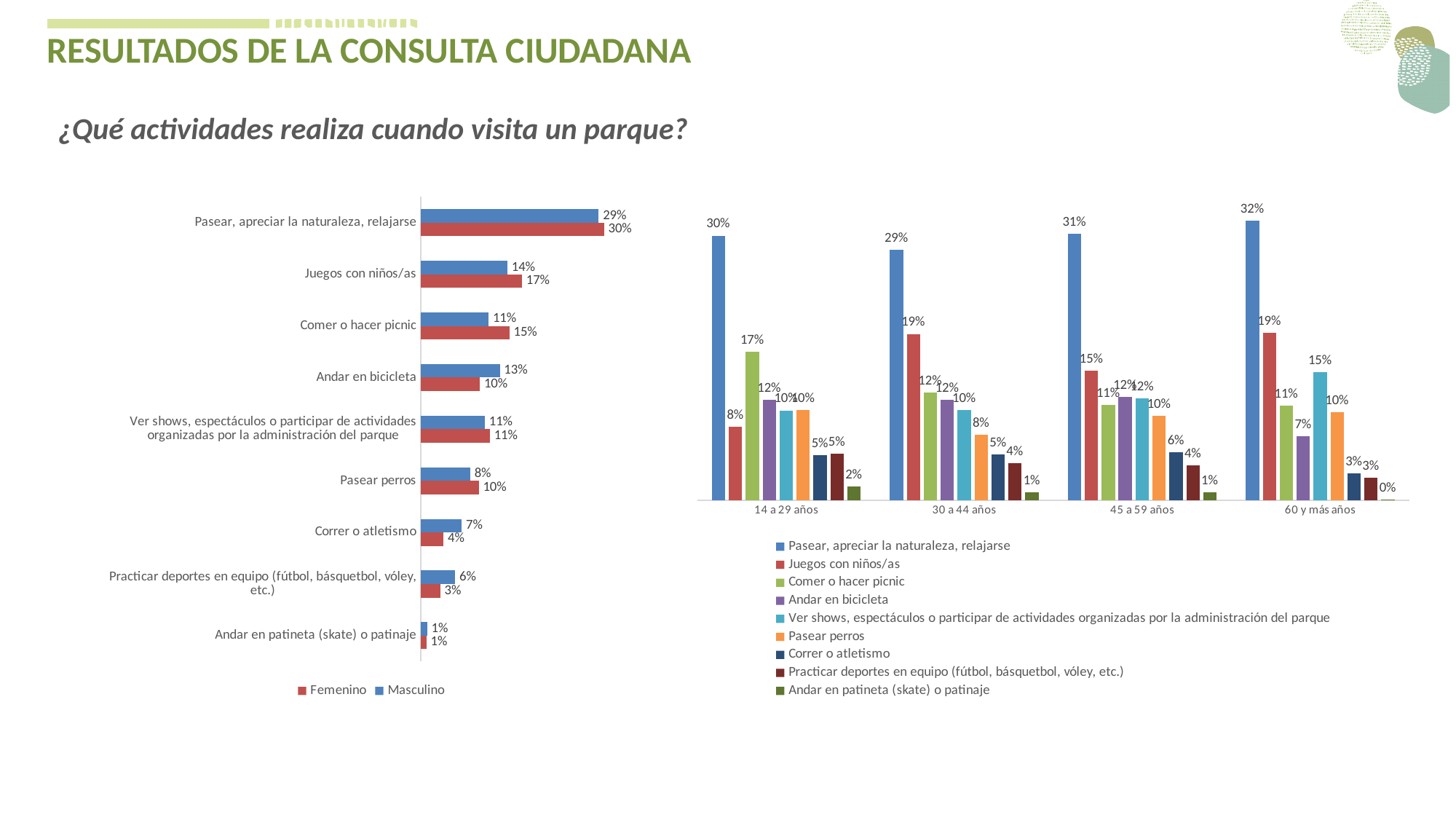
What kind of chart is the right chart (by age group)? Bar chart In the left chart (by gender), what is the difference between the Femenino and Masculino values for 'Comer o hacer picnic'? 4% In the left chart (by gender), which is larger for 'Correr o atletismo': Femenino or Masculino? Masculino In the left chart (by gender), which activity has the lowest values for both series? Andar en patineta (skate) o patinaje In the right chart (by age group), how many series does the legend list? 9 In the left chart (by gender), how many series does the legend list? 2 In the left chart (by gender), how many activity categories are shown? 9 In the left chart (by gender), what is the Femenino value for 'Juegos con niños/as'? 17% In the right chart (by age group), which age group has the highest value for 'Pasear, apreciar la naturaleza, relajarse'? 60 y más años In the right chart (by age group), what is the difference between 'Juegos con niños/as' in '30 a 44 años' and in '14 a 29 años'? 11% In the right chart (by age group), what is the value for 'Comer o hacer picnic' in the '14 a 29 años' group? 17% In the left chart (by gender), what is the Masculino value for 'Andar en bicicleta'? 13%